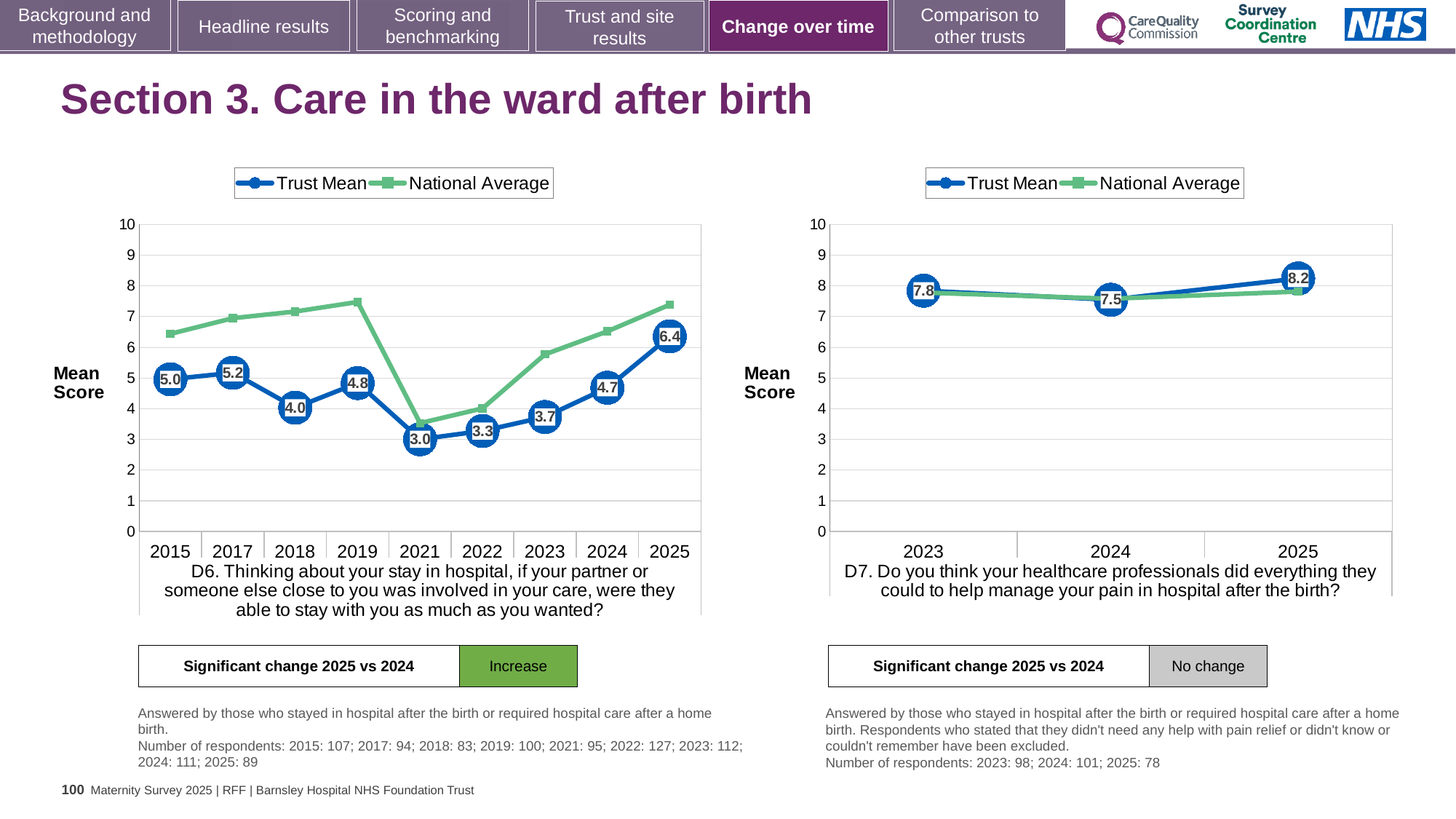
In the left chart (D6), which year has the lowest Trust Mean score? 2021 In the left chart (D6), which year has the highest Trust Mean score? 2025 In the right chart (D7), is the Trust Mean score for 2023 larger or smaller than the score for 2024? larger In the left chart (D6), what is the Trust Mean score for 2025? 6.4 In the left chart (D6), what is the difference between the Trust Mean scores for 2025 and 2024? 1.7 In the left chart (D6), how many years are plotted on the x axis? 9 In the right chart (D7), what is the Trust Mean score for 2024? 7.5 In the right chart (D7), which year has the highest Trust Mean score? 2025 In the left chart (D6), what does the 'Significant change 2025 vs 2024' box say? Increase What kind of chart is the right chart (D7)? line chart In the right chart (D7), how many series does the legend list? 2 In the left chart (D6), is the National Average for 2019 greater or less than 7? greater